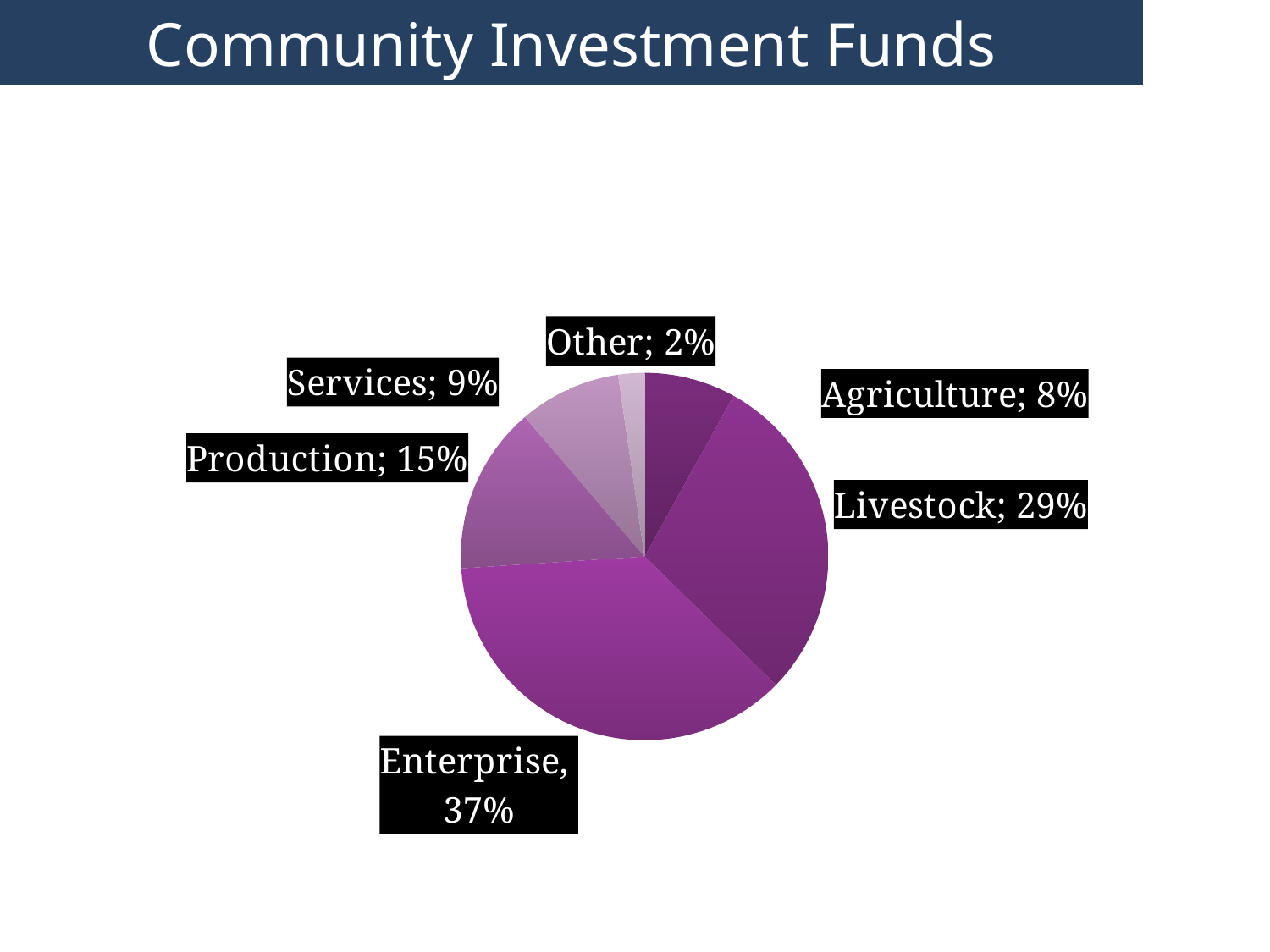
Which is larger, Production or Services? Production What is the difference between the Enterprise and Livestock shares? 8% What kind of chart is shown on the slide? pie chart What share of the pie does Enterprise have? 37% What is the value for Production? 15% What is the value for Agriculture? 8% Which category has the largest slice? Enterprise Which category has the smallest slice? Other How many categories are shown in the pie chart? 6 What is the value for Services? 9% What is the title of the slide containing the chart? Community Investment Funds What is the value for Livestock? 29%